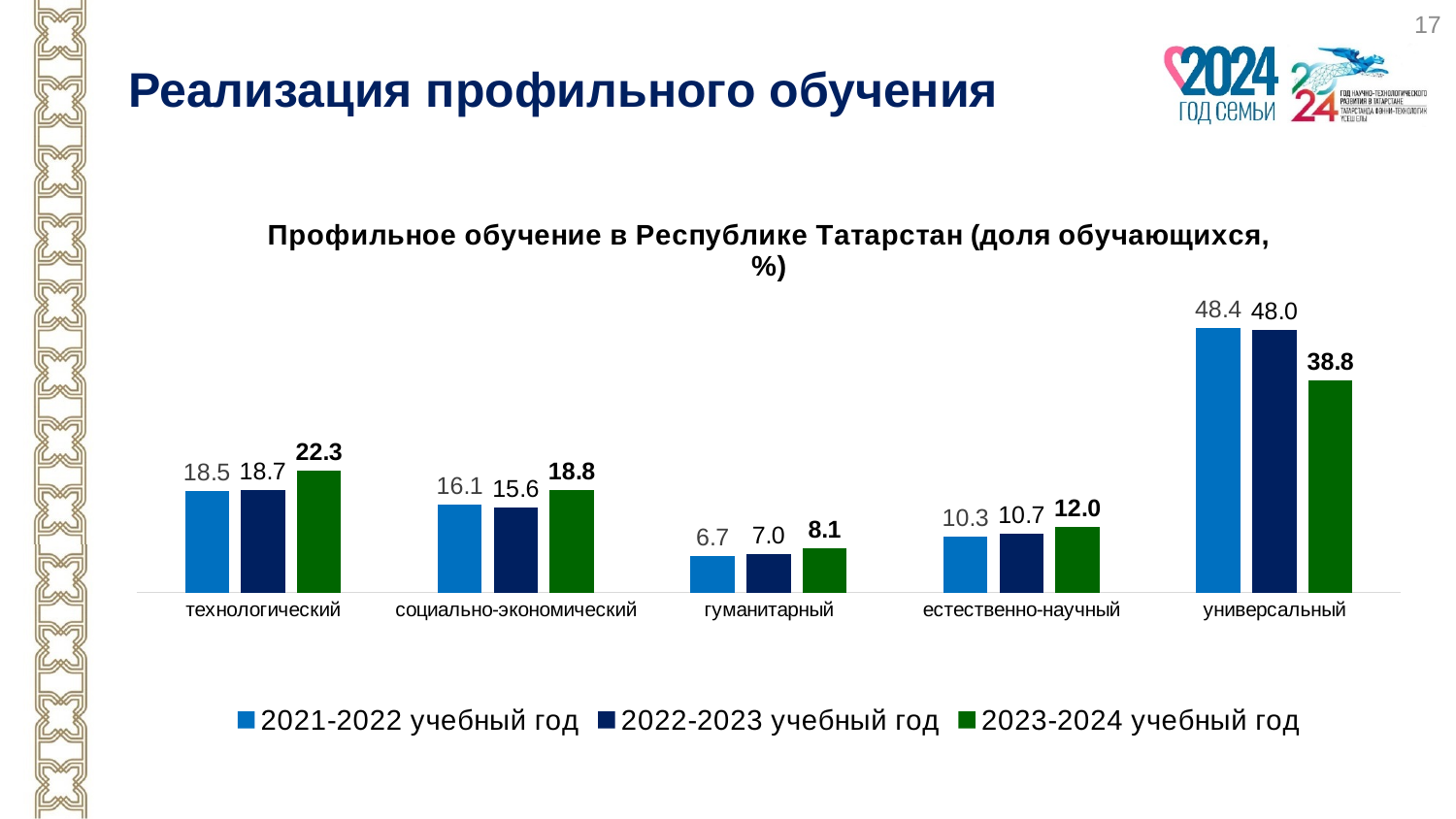
How many series does the legend list? 3 How many categories are shown on the x axis? 5 What is the value for технологический in the 2023-2024 учебный год series? 22.3 What is the difference between the 2021-2022 and 2023-2024 values for универсальный? 9.6 What is the value for универсальный in the 2021-2022 учебный год series? 48.4 Which category has the highest value in the 2023-2024 учебный год series? универсальный What is the value for гуманитарный in the 2022-2023 учебный год series? 7.0 Which category has the lowest value in the 2021-2022 учебный год series? гуманитарный What is the title of the chart? Профильное обучение в Республике Татарстан (доля обучающихся, %) Do the values for естественно-научный rise or fall from 2021-2022 to 2023-2024? rise What kind of chart is shown on the slide? bar chart Which is larger for социально-экономический: the 2021-2022 учебный год value or the 2023-2024 учебный год value? 2023-2024 учебный год